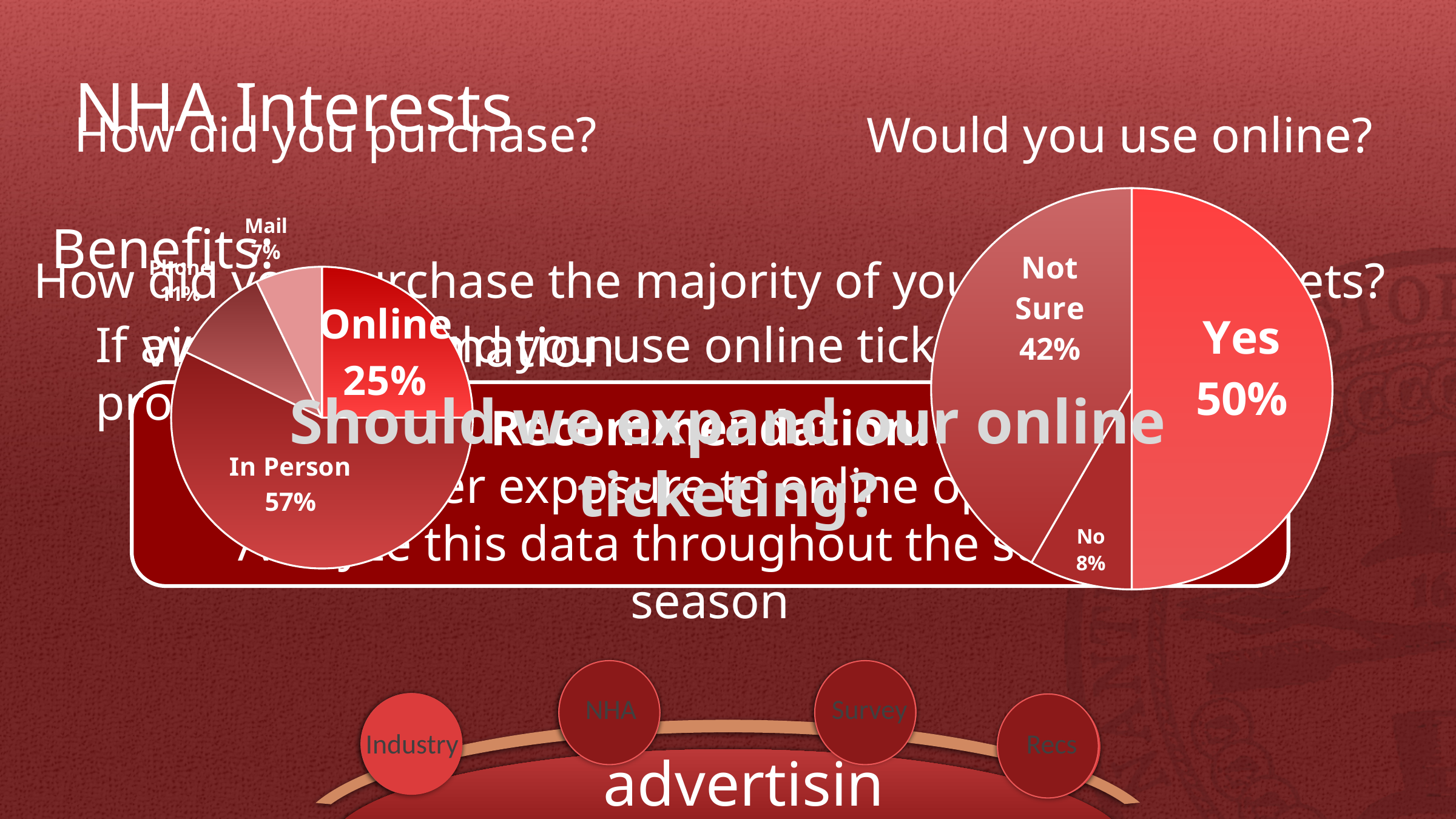
In the 'How did you purchase?' chart, what share is Online? 25% In the 'Would you use online?' chart, what share answered No? 8% In the 'Would you use online?' chart, which category has the smallest slice? No In the 'How did you purchase?' chart, what share is In Person? 57% What kind of chart is the 'How did you purchase?' chart? pie chart How many slices does the 'Would you use online?' pie chart have? 3 In the 'How did you purchase?' chart, which is larger, Online or Mail? Online In the 'Would you use online?' chart, what share answered Yes? 50% In the 'How did you purchase?' chart, which category has the largest slice? In Person In the 'How did you purchase?' chart, what share is Mail? 7% In the 'Would you use online?' chart, what share answered Not Sure? 42% In the 'How did you purchase?' chart, how many percentage points larger is In Person than Online? 32 percentage points